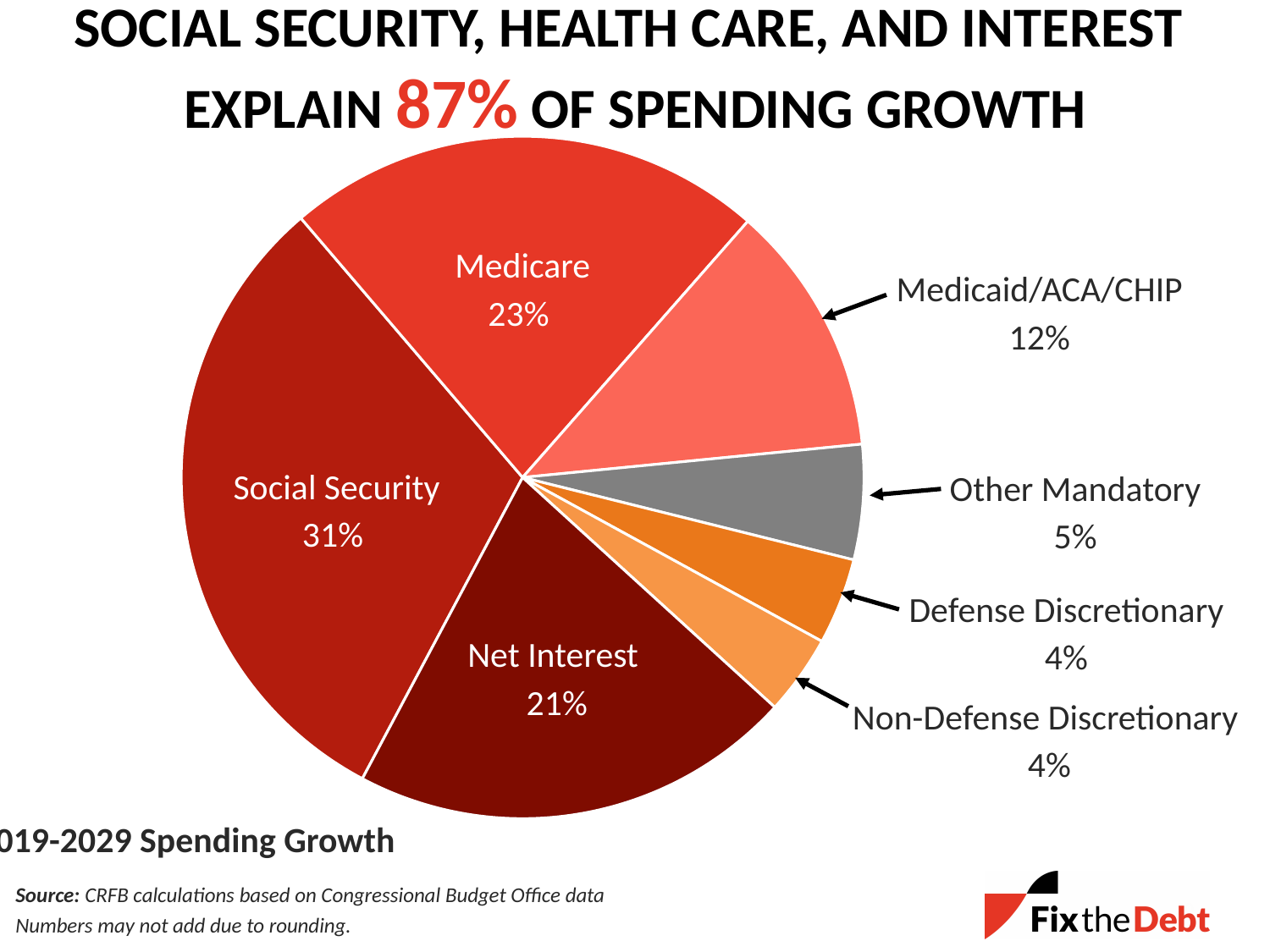
What is the difference in percentage points between Social Security and Net Interest? 10 What is the combined share of Defense Discretionary and Non-Defense Discretionary? 8% What period of spending growth does the chart cover? 2019-2029 How many categories are shown in the pie chart? 7 What kind of chart is shown on the slide? Pie chart What share of spending growth does Social Security account for? 31% Which is larger, Medicare or Medicaid/ACA/CHIP? Medicare Which category has the largest slice of the pie? Social Security What share of spending growth does Net Interest account for? 21% What share of spending growth does Other Mandatory account for? 5% What share of spending growth does Medicaid/ACA/CHIP account for? 12% What share of spending growth does Medicare account for? 23%